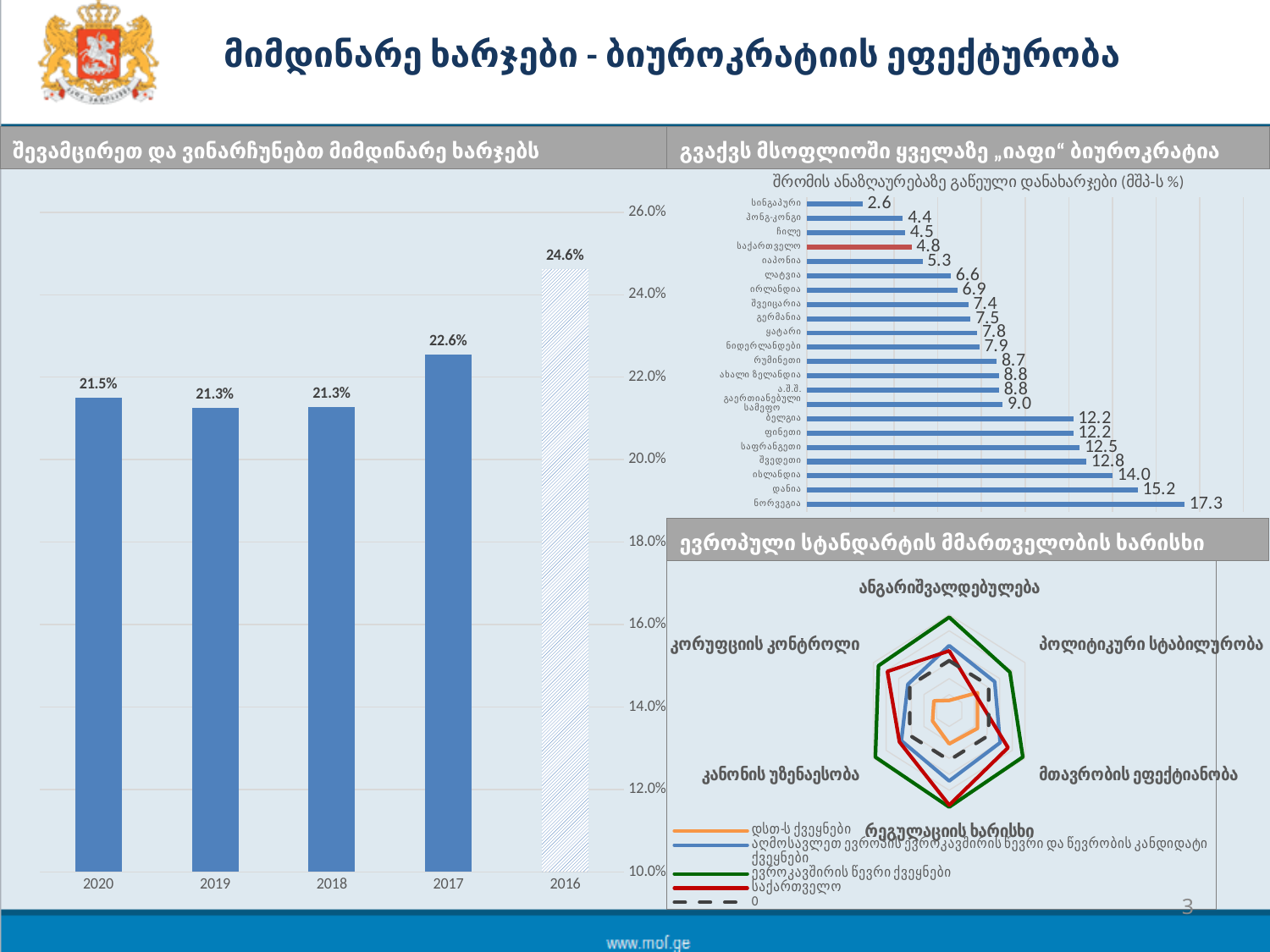
In the horizontal bar chart at the top right of the slide, what is the value for საქართველო? 4.8 In the bar chart on the left of the slide, do the values generally rise or fall from 2016 to 2020? fall In the horizontal bar chart at the top right of the slide, which country has the highest value? ნორვეგია In the horizontal bar chart at the top right of the slide, which is larger, the value for დანია or the value for ისლანდია? დანია In the bar chart on the left of the slide, which year has the highest value? 2016 In the bar chart on the left of the slide, how many years are shown on the x axis? 5 What kind of chart is shown at the bottom right of the slide? radar chart In the horizontal bar chart at the top right of the slide, which country has the lowest value? სინგაპური In the bar chart on the left of the slide, what is the value for 2020? 21.5% In the bar chart on the left of the slide, what is the difference between the values for 2016 and 2020? 3.1% In the bar chart on the left of the slide, what is the value for 2017? 22.6% In the horizontal bar chart at the top right of the slide, what is the difference between the values for ნორვეგია and სინგაპური? 14.7